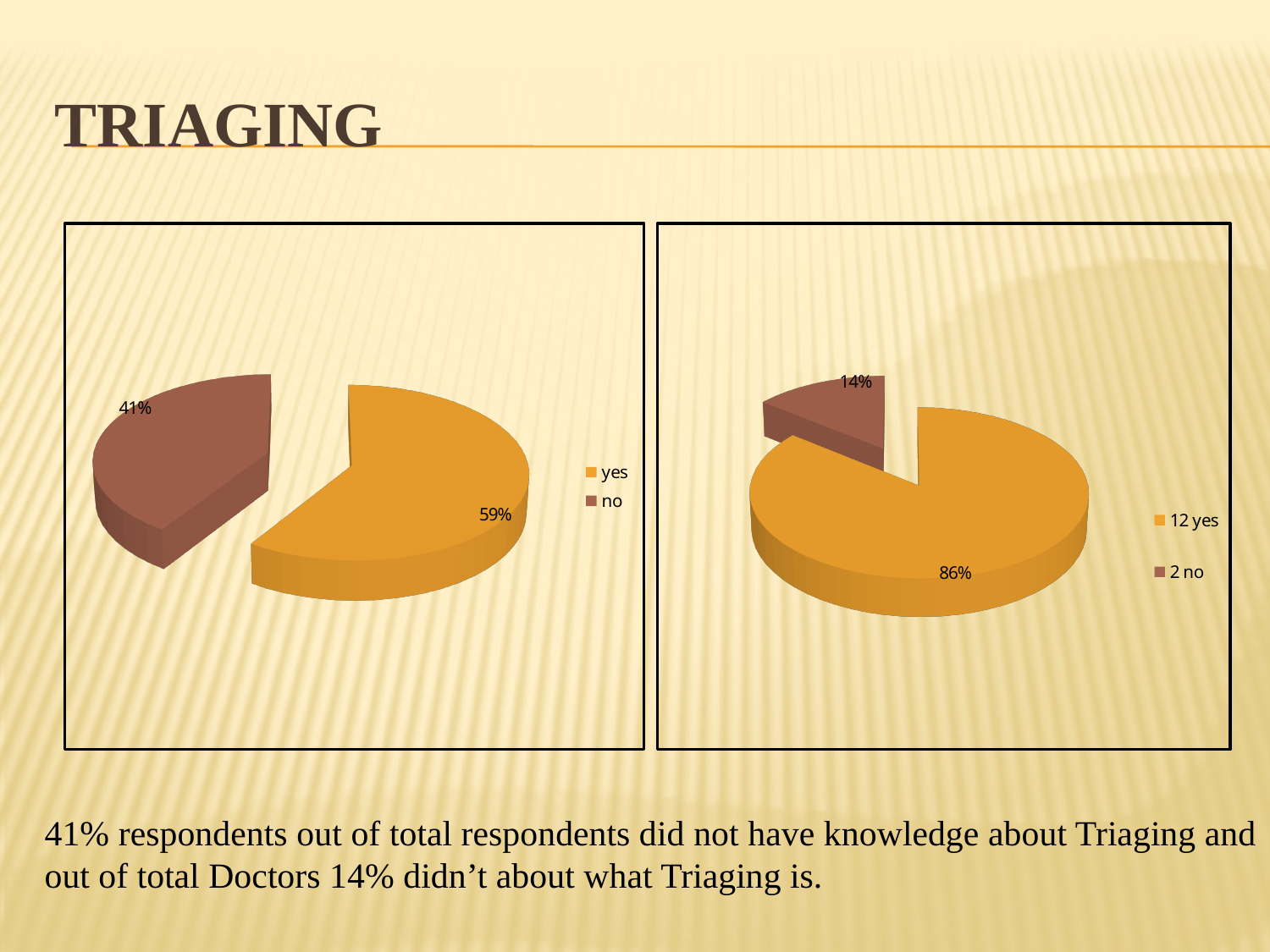
In the right pie chart, which slice is the smallest? 2 no In the right pie chart, what is the difference between the "12 yes" and "2 no" shares? 72% How many slices does the right pie chart have? 2 In the left pie chart, what share is labelled for "no"? 41% What are the legend entries of the right pie chart? 12 yes, 2 no In the left pie chart, what share is labelled for "yes"? 59% In the left pie chart, which slice is the largest? yes Which is larger: the "no" share in the left pie chart or the "2 no" share in the right pie chart? no (left chart) What type of chart is shown on the left of the slide? Pie chart In the right pie chart, what share is labelled for "12 yes"? 86% In the left pie chart, what is the difference between the "yes" and "no" shares? 18%